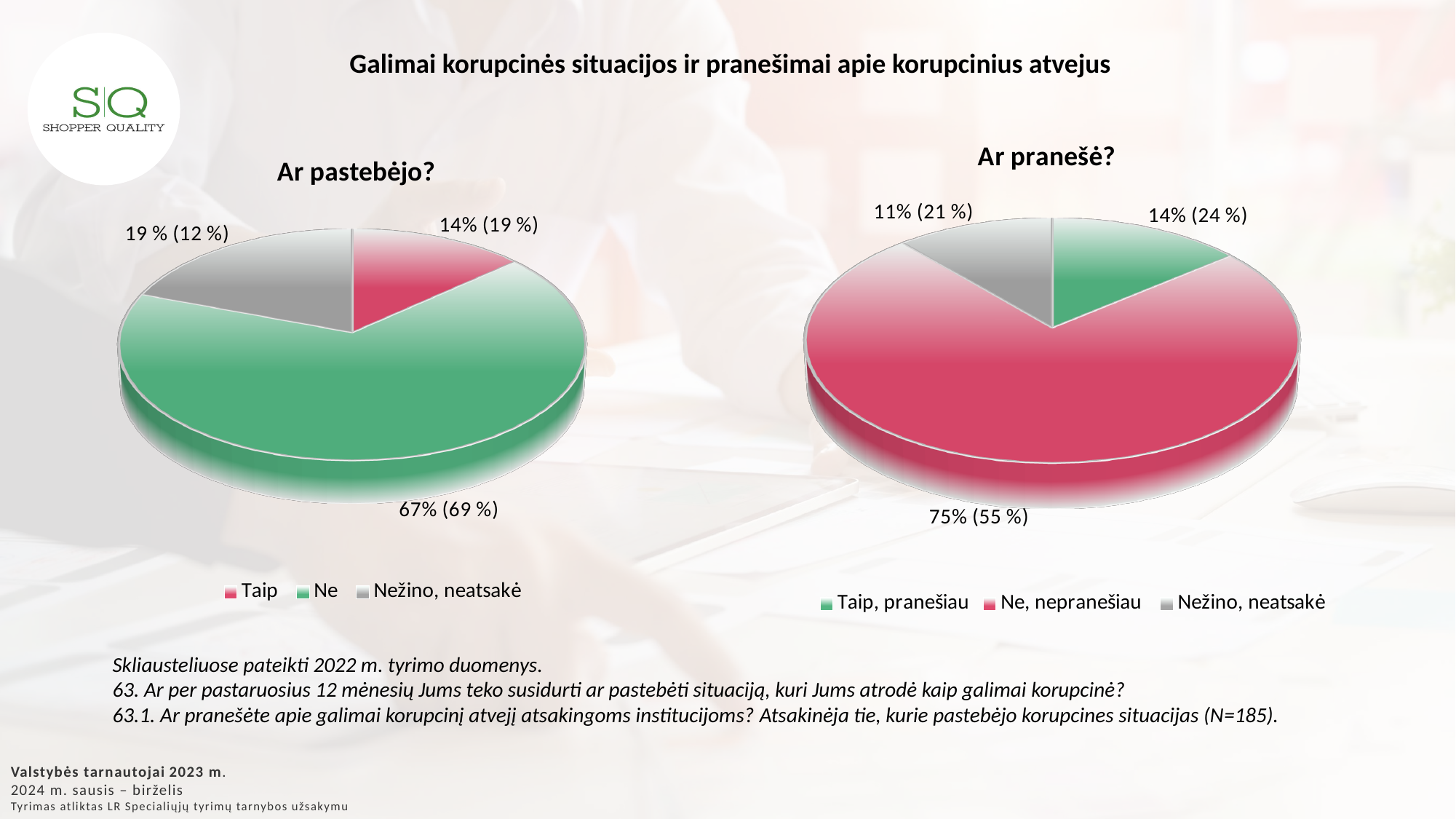
In the 'Ar pranešė?' chart, what is the value for 'Ne, nepranešiau'? 75% In the 'Ar pranešė?' chart, what 2022 value is shown in parentheses for 'Taip, pranešiau'? 24 % In the 'Ar pastebėjo?' chart, what is the value for 'Ne'? 67% What colour is the 'Ne, nepranešiau' slice in the 'Ar pranešė?' chart? Red In the 'Ar pastebėjo?' chart, what is the value for 'Taip'? 14% In the 'Ar pranešė?' chart, which is larger: 'Taip, pranešiau' or 'Nežino, neatsakė'? Taip, pranešiau What type of chart is the 'Ar pranešė?' chart? Pie chart In the 'Ar pastebėjo?' chart, what is the difference between the 'Ne' and 'Taip' values? 53 percentage points In the 'Ar pastebėjo?' chart, which category has the largest share? Ne How many slices does the 'Ar pastebėjo?' chart have? 3 In the 'Ar pranešė?' chart, which category has the smallest share? Nežino, neatsakė In the 'Ar pranešė?' chart, what is the value for 'Nežino, neatsakė'? 11%